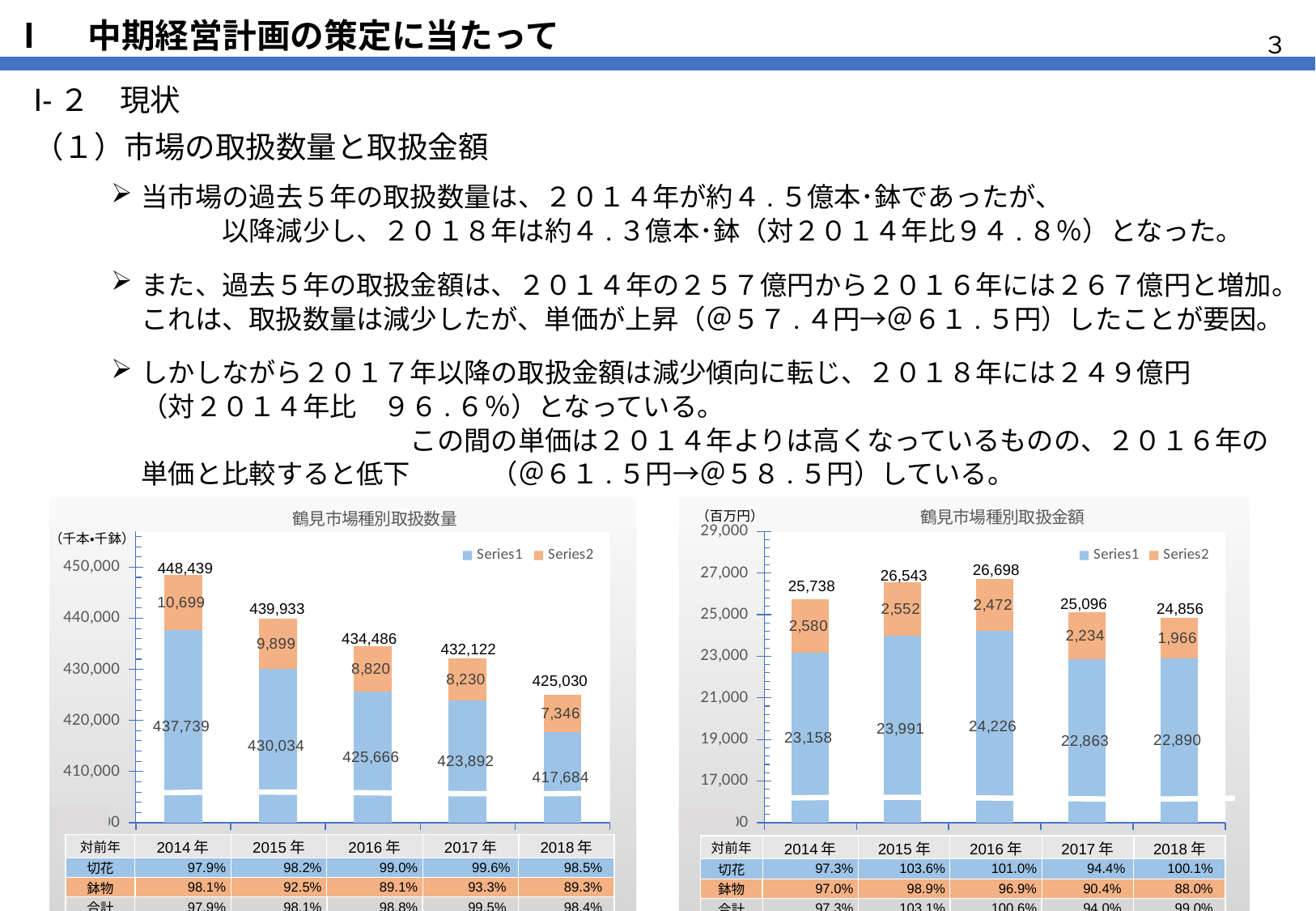
In the 鶴見市場種別取扱金額 chart, what is the difference between the totals for 2016年 and 2018年? 1,842 In the 鶴見市場種別取扱数量 chart, what is the difference between the Series1 values for 2014年 and 2018年? 20,055 In the 鶴見市場種別取扱金額 chart, which is larger, the Series2 value for 2014年 or for 2018年? 2014年 In the 鶴見市場種別取扱数量 chart, do the bar totals rise or fall from 2014年 to 2018年? fall In the 鶴見市場種別取扱数量 chart, what is the total value labelled above the 2014年 bar? 448,439 How many years are shown on the x axis of the 鶴見市場種別取扱金額 chart? 5 In the 鶴見市場種別取扱金額 chart, which year has the highest total? 2016年 In the 鶴見市場種別取扱数量 chart, which year has the lowest total? 2018年 In the 鶴見市場種別取扱金額 chart, what is the Series1 value for 2016年? 24,226 How many series does the legend of the 鶴見市場種別取扱数量 chart list? 2 In the 鶴見市場種別取扱数量 chart, what is the Series2 value for 2018年? 7,346 What type of chart is the 鶴見市場種別取扱金額 chart? stacked bar chart